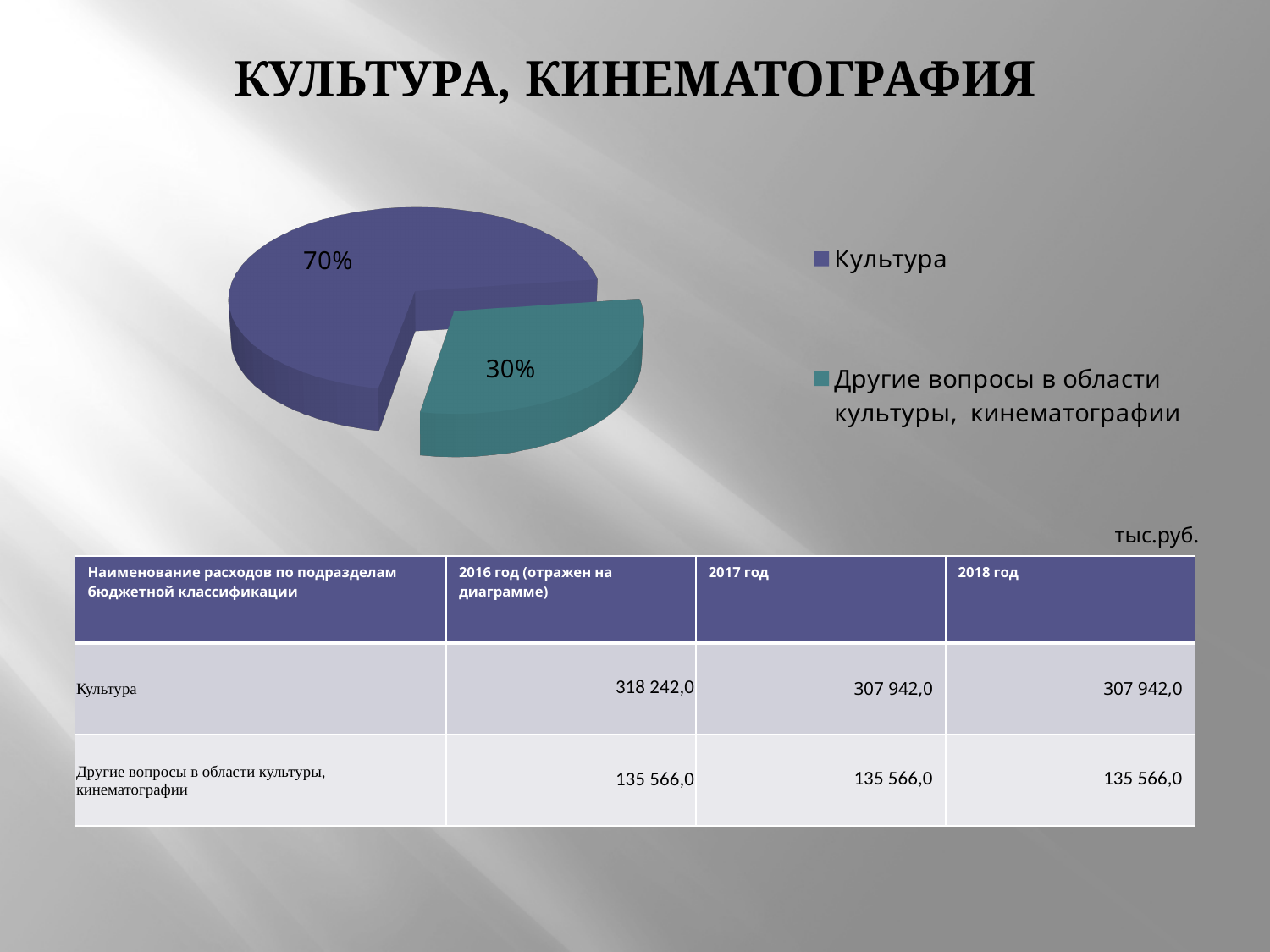
How many slices does the pie chart have? 2 Which year's data does the table say is reflected in the pie chart? 2016 год Which is larger in the pie chart: Культура or Другие вопросы в области культуры, кинематографии? Культура What share of the pie does the Культура slice represent? 70% By how many percentage points does the Культура slice exceed the Другие вопросы в области культуры, кинематографии slice? 40 What kind of chart is shown on the slide? pie chart What share of the pie does the slice for Другие вопросы в области культуры, кинематографии represent? 30% How many entries does the legend of the pie chart list? 2 Which slice of the pie chart is the largest? Культура Which slice of the pie chart is the smallest? Другие вопросы в области культуры, кинематографии According to the table, what is the 2016 value for Культура that is reflected in the pie chart? 318 242,0 What colour is the Культура slice in the pie chart? purple